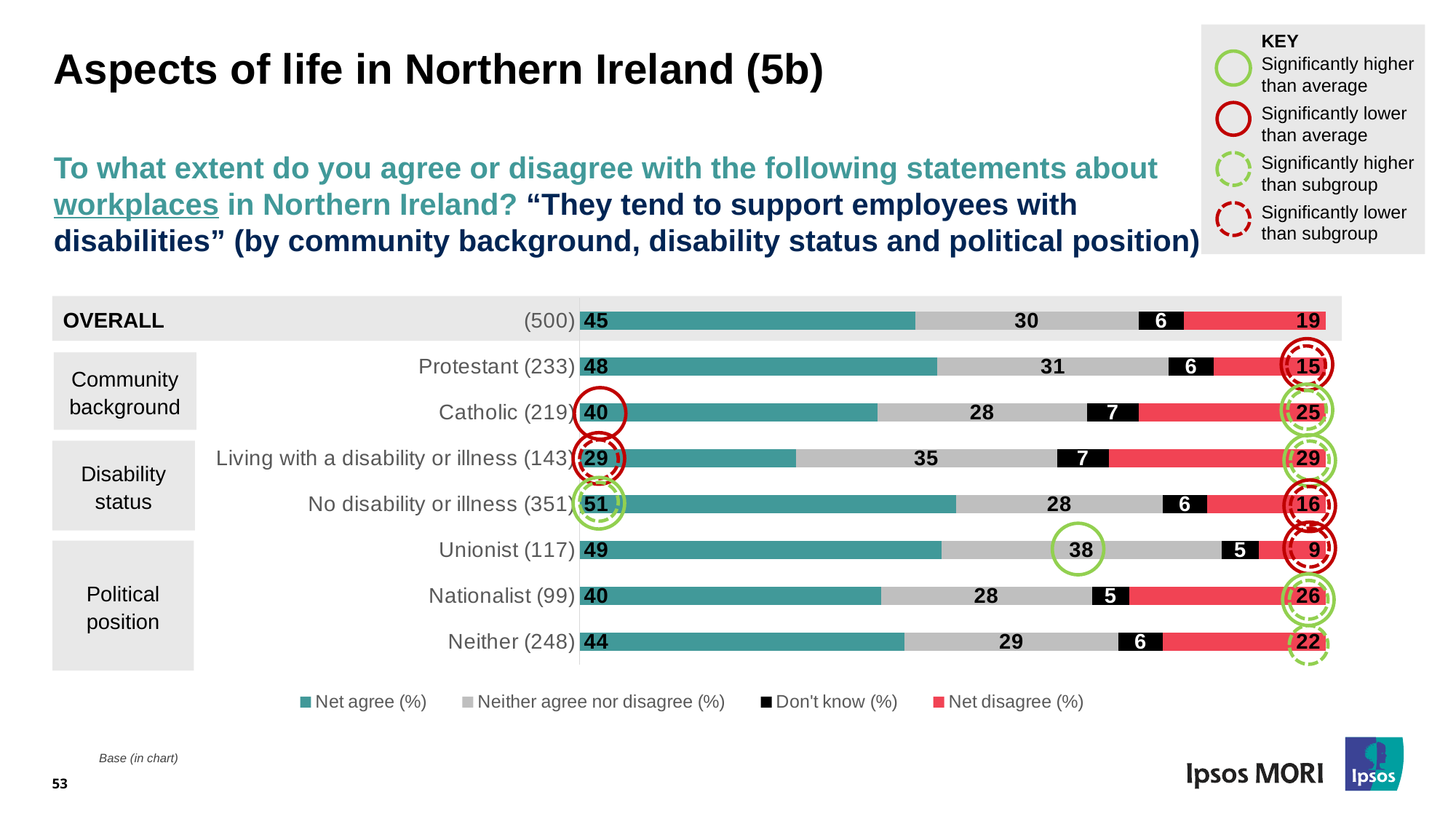
How many series does the legend list? 4 Which series is shown in red in the chart? Net disagree (%) Which category has the lowest Net disagree (%) value? Unionist (117) What is the Net disagree (%) value for Catholic (219)? 25 What is the difference between the Net agree (%) values for Protestant (233) and Catholic (219)? 8 Which is larger: the Net disagree (%) value for Nationalist (99) or for Neither (248)? Nationalist (99) What kind of chart is shown on the slide? Stacked bar chart How many categories (bars) are shown in the chart? 8 What is the Neither agree nor disagree (%) value for Living with a disability or illness (143)? 35 What is the Net agree (%) value for Unionist (117)? 49 What is the Don't know (%) value for OVERALL (500)? 6 Which category has the highest Net agree (%) value? No disability or illness (351)